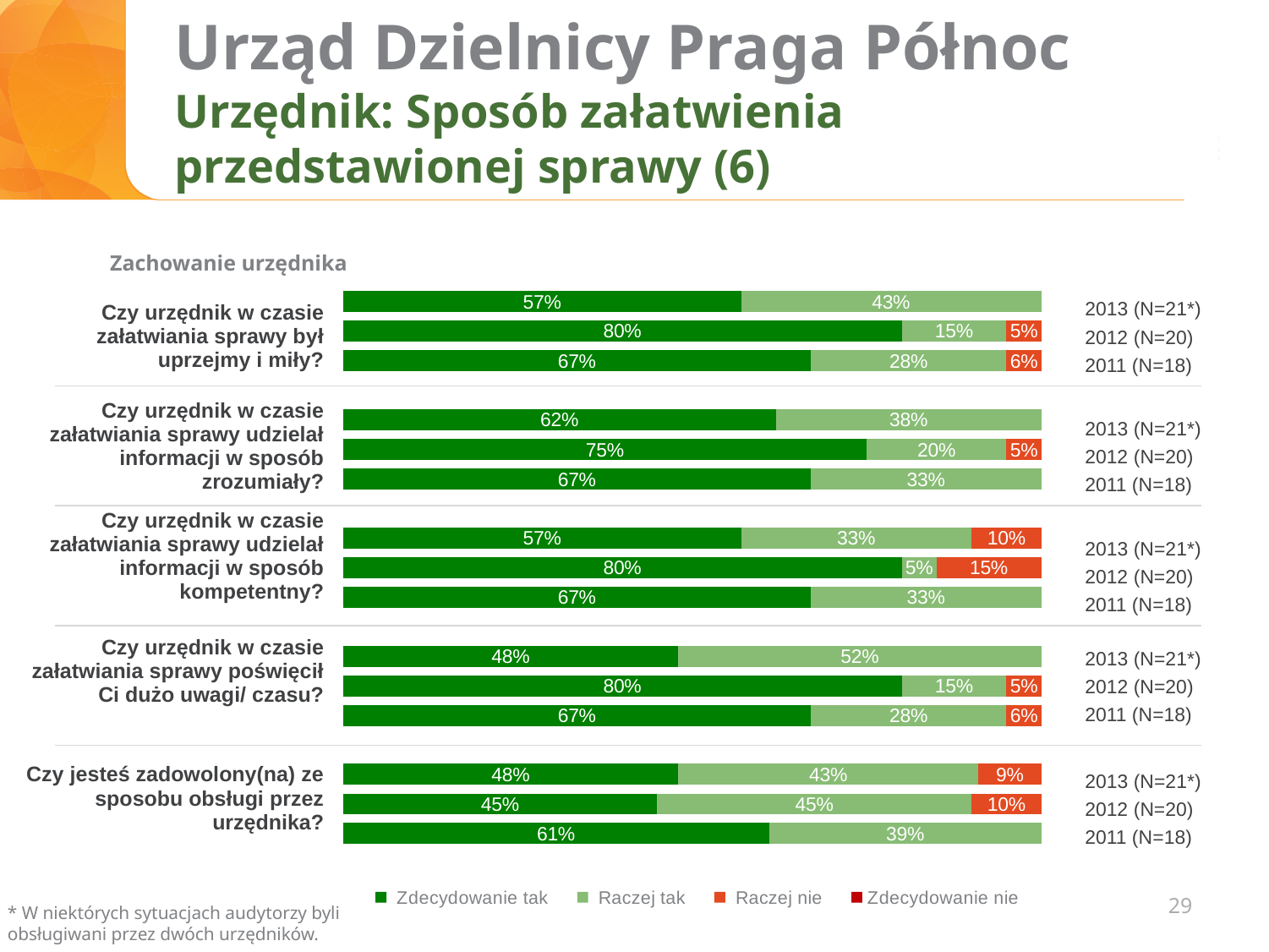
Across all bars in the chart, what is the lowest "Zdecydowanie tak" value shown? 45% (2012, Czy jesteś zadowolony(na) ze sposobu obsługi przez urzędnika?) What kind of chart is shown on the slide? Stacked bar chart What is the total of the 2013 (N=21*) bar for "Czy urzędnik w czasie załatwiania sprawy udzielał informacji w sposób kompetentny?" (57% + 33% + 10%)? 100% How many response categories does the legend list? 4 For "Czy urzędnik w czasie załatwiania sprawy był uprzejmy i miły?", how many percentage points higher was the "Zdecydowanie tak" share in 2012 than in 2013? 23 percentage points For the question "Czy jesteś zadowolony(na) ze sposobu obsługi przez urzędnika?", what percentage answered "Raczej tak" in 2011 (N=18)? 39% For the question "Czy urzędnik w czasie załatwiania sprawy był uprzejmy i miły?", what percentage answered "Zdecydowanie tak" in 2012 (N=20)? 80% For the question "Czy jesteś zadowolony(na) ze sposobu obsługi przez urzędnika?", what percentage answered "Raczej nie" in 2013 (N=21*)? 9% For the question "Czy urzędnik w czasie załatwiania sprawy udzielał informacji w sposób kompetentny?", what percentage answered "Raczej nie" in 2012 (N=20)? 15% In 2013 (N=21*), which question had a larger "Zdecydowanie tak" share: "...udzielał informacji w sposób kompetentny?" or "...poświęcił Ci dużo uwagi/ czasu?"? Czy urzędnik w czasie załatwiania sprawy udzielał informacji w sposób kompetentny? (57% vs 48%) Among the 2013 (N=21*) bars, which question has the highest "Zdecydowanie tak" share? Czy urzędnik w czasie załatwiania sprawy udzielał informacji w sposób zrozumiały? (62%) How many survey questions are shown in the chart? 5